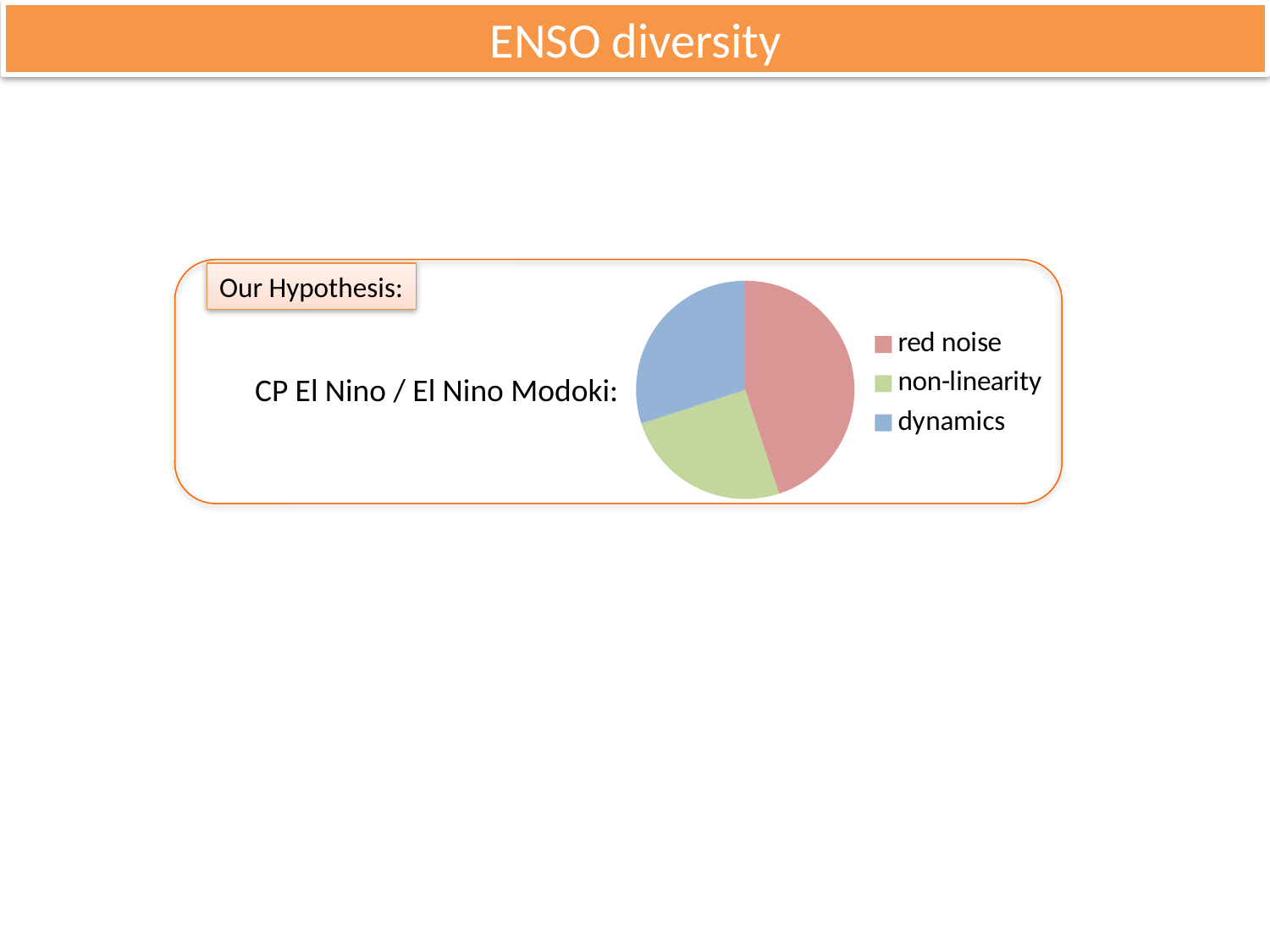
Which slice is larger in the pie chart, red noise or dynamics? red noise What kind of chart is shown on the slide? pie chart Which category has the largest slice in the pie chart? red noise What colour is the non-linearity slice in the pie chart? green What are the three categories listed in the legend of the pie chart? red noise, non-linearity, dynamics How many entries does the legend of the pie chart list? 3 Which slice is larger in the pie chart, red noise or non-linearity? red noise How many slices does the pie chart have? 3